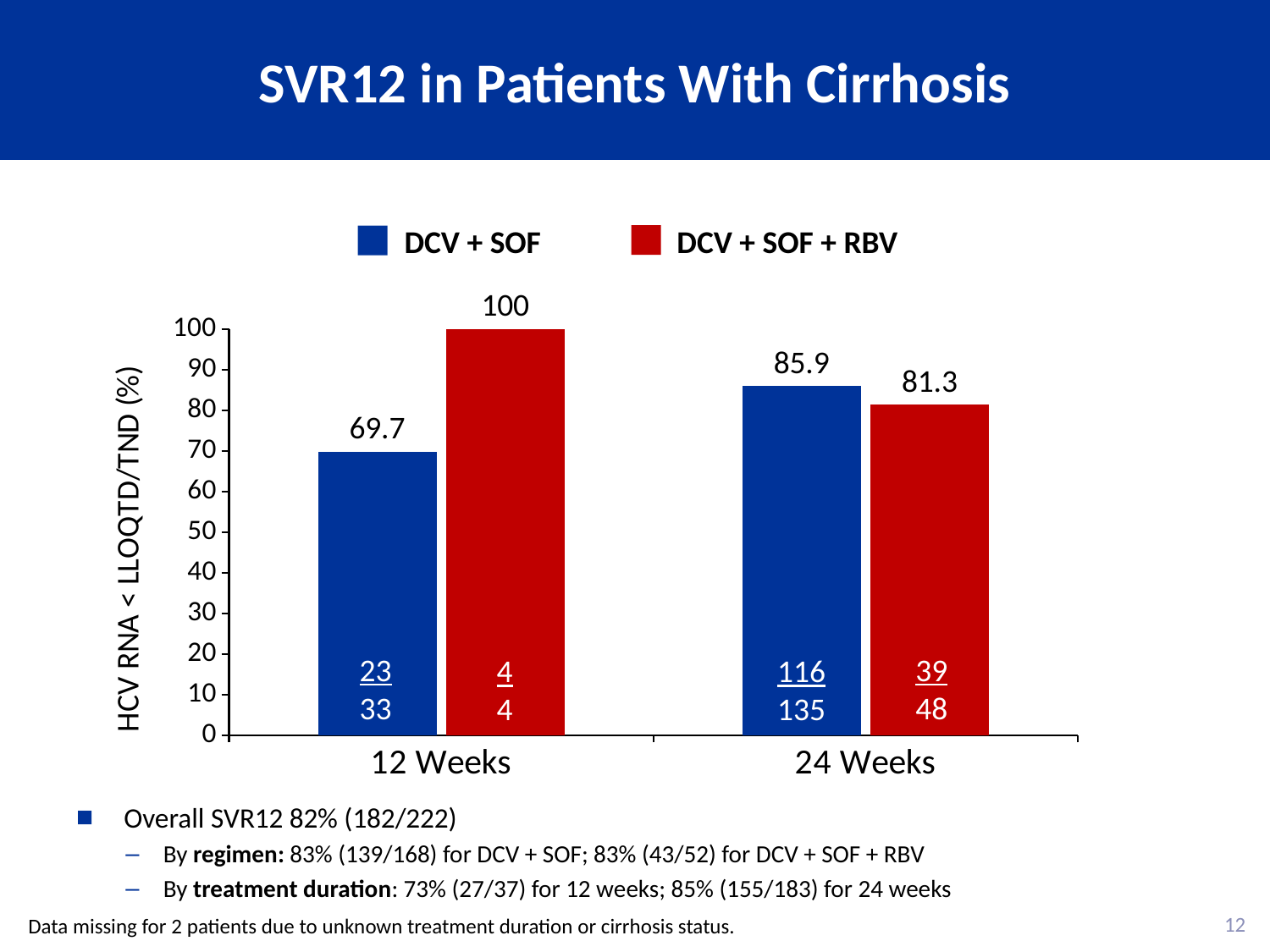
How many series does the legend list? 2 What is the SVR12 value for DCV + SOF at 12 weeks? 69.7 What is the SVR12 value for DCV + SOF at 24 weeks? 85.9 How many categories are shown on the x axis? 2 What is the SVR12 value for DCV + SOF + RBV at 24 weeks? 81.3 Which bar has the lowest value on the chart? DCV + SOF at 12 Weeks At 24 weeks, which regimen has the larger value, DCV + SOF or DCV + SOF + RBV? DCV + SOF What kind of chart is shown on the slide? Bar chart Which bar has the highest value on the chart? DCV + SOF + RBV at 12 Weeks What is the difference between the DCV + SOF + RBV and DCV + SOF values at 12 weeks? 30.3 What is the label of the y axis? HCV RNA < LLOQTD/TND (%) What is the SVR12 value for DCV + SOF + RBV at 12 weeks? 100